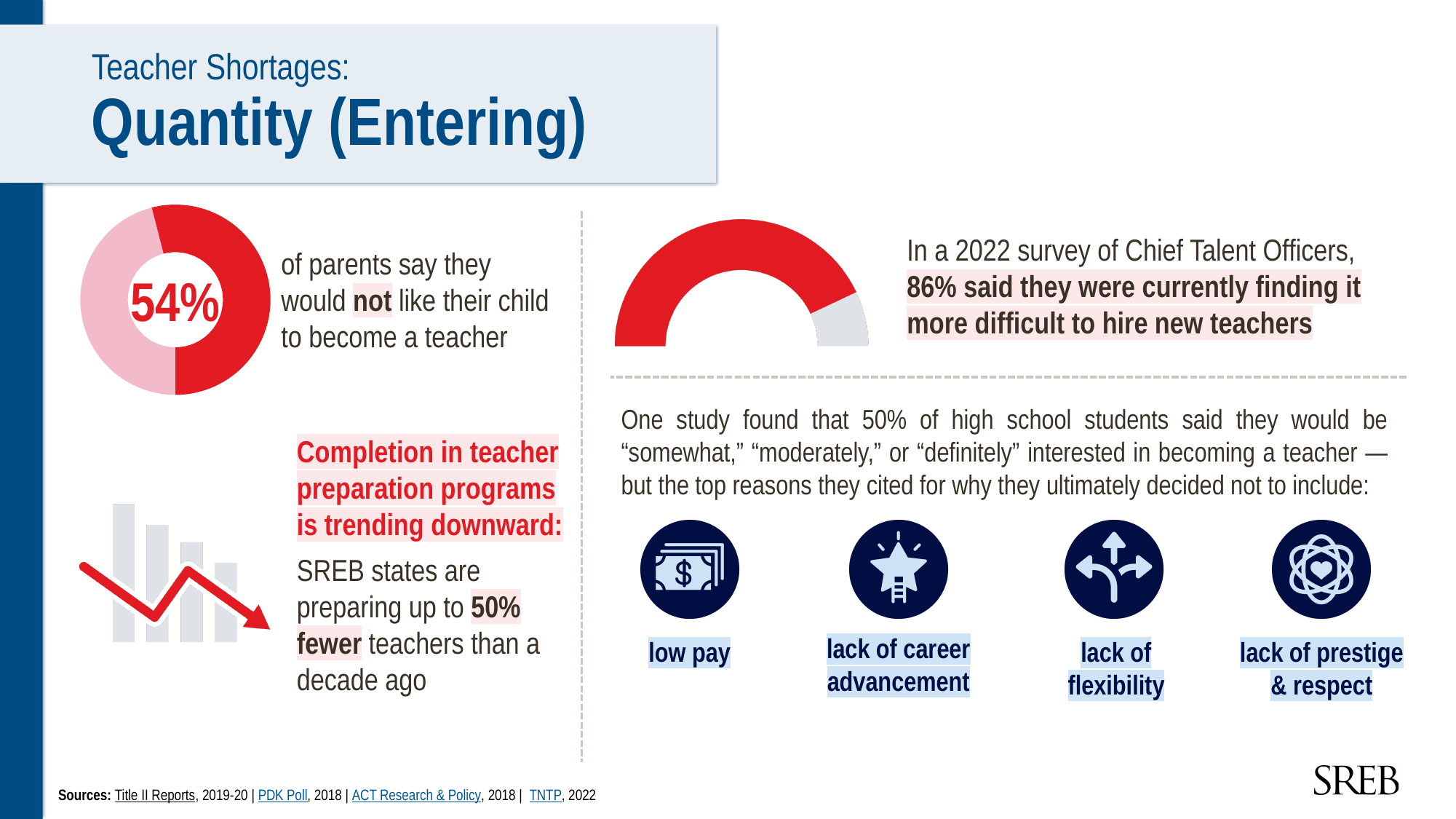
What kind of chart is the half-circle graphic at the top right of the slide? gauge (semicircle) chart What percentage does the red semicircle gauge at the top right represent? 86% What colour is the larger slice of the donut chart on the left? red What percentage is shown in the centre of the donut chart on the left of the slide? 54% How many bars are shown in the bar chart graphic at the bottom left of the slide? 4 In the donut chart on the left, is the red slice larger or smaller than the pink slice? larger What colour is the arrow overlaid on the bar chart graphic at the bottom left? red In the donut chart on the left, is the red slice greater or less than 50% of the circle? greater What kind of chart is the circular graphic on the left showing 54%? donut (pie) chart In the donut chart on the left, what share of parents say they would not like their child to become a teacher? 54% In the bar chart graphic at the bottom left, do the bars rise or fall from left to right? fall In the semicircle gauge at the top right, is the red filled portion greater or less than 50%? greater